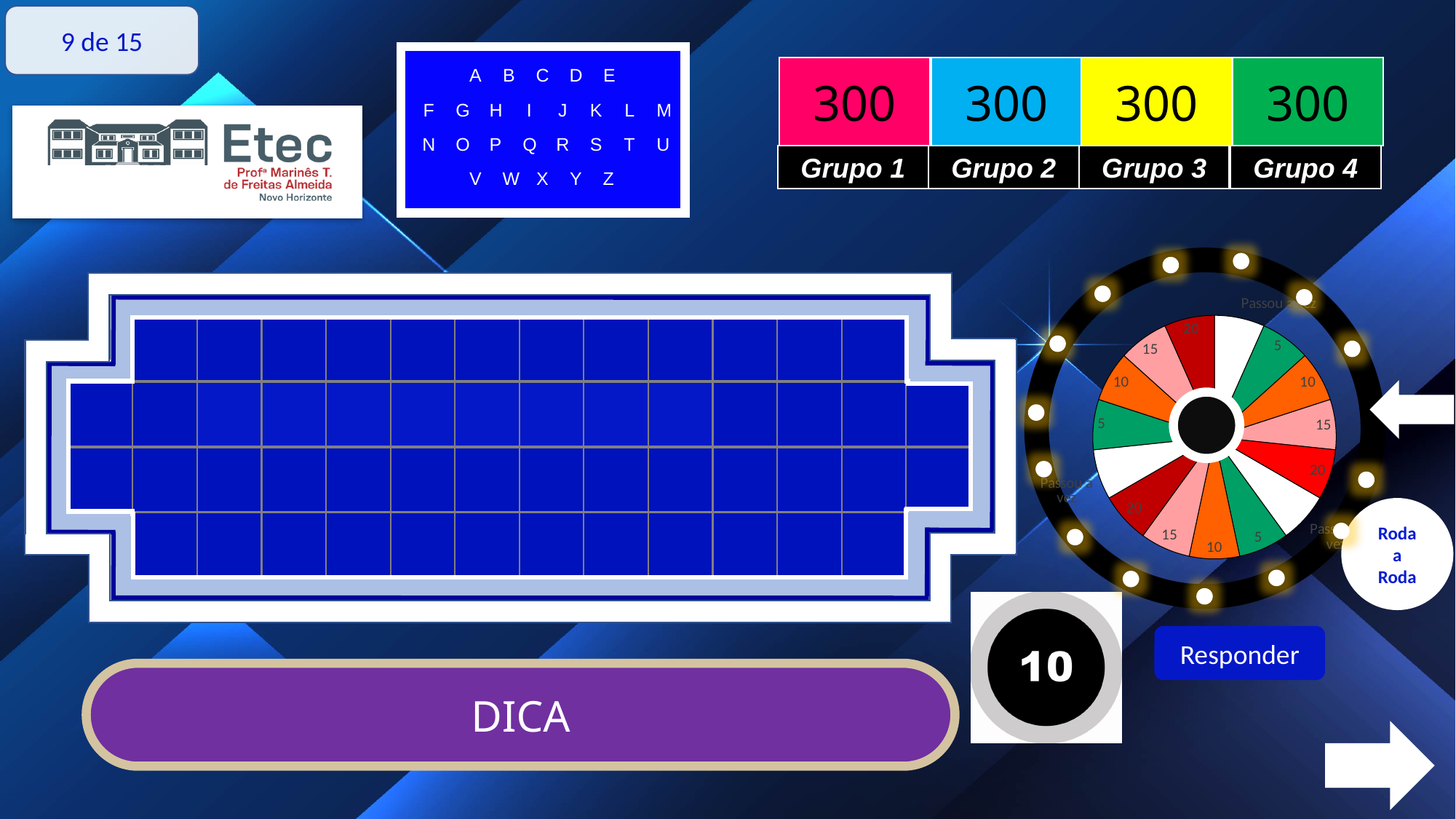
What is the lowest numeric value printed on a segment of the wheel? 5 What kind of chart is the wheel on the right side of the slide? pie chart What is the difference between the highest and lowest numeric values on the wheel? 15 What colour are the wheel segments labelled 20? red What text appears on the white segments of the wheel? Passou a vez What is the highest numeric value printed on a segment of the wheel? 20 How many segments of the wheel are labelled 20? 3 How many segments does the wheel have in total? 15 Which is larger on the wheel, the value on a green segment or the value on an orange segment? orange segment (10) How many different numeric values appear on the wheel's segments? 4